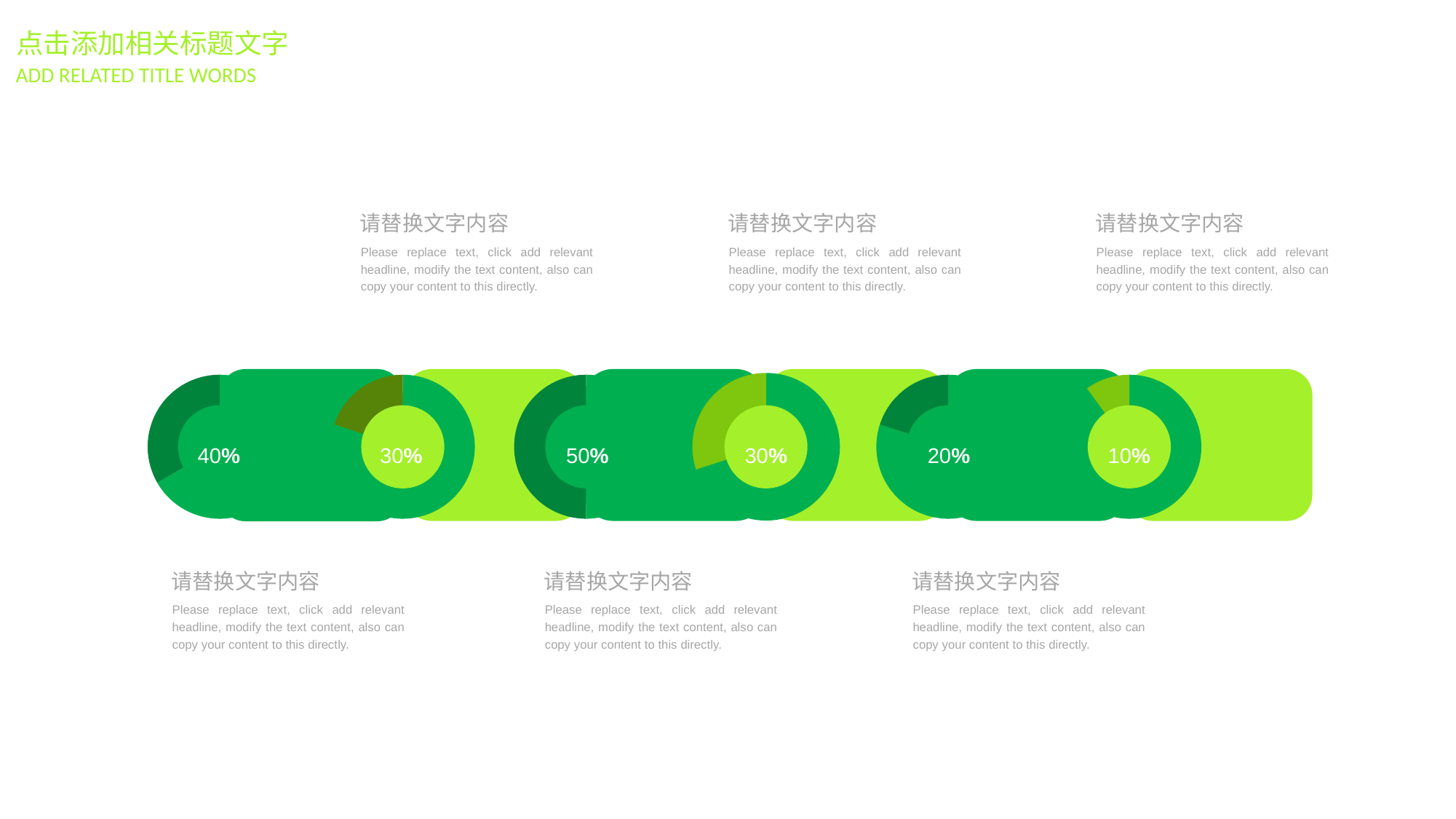
What kind of chart is used to display the percentages on the slide? Ring (donut) chart What value is shown in the sixth (rightmost) ring chart? 10% Which ring chart shows the highest percentage? The third from the left (50%) What is the difference between the value in the third ring chart and the value in the rightmost ring chart? 40% What is the difference between the values in the first and second ring charts? 10% Which is larger, the value in the first ring chart or the value in the fifth ring chart? The first ring chart (40%) What value is shown in the fifth ring chart from the left? 20% Which ring chart shows the lowest percentage? The rightmost one (10%) How many ring charts are shown on the slide? 6 What value is shown in the first (leftmost) ring chart? 40% What value is shown in the second ring chart from the left? 30% What value is shown in the third ring chart from the left? 50%